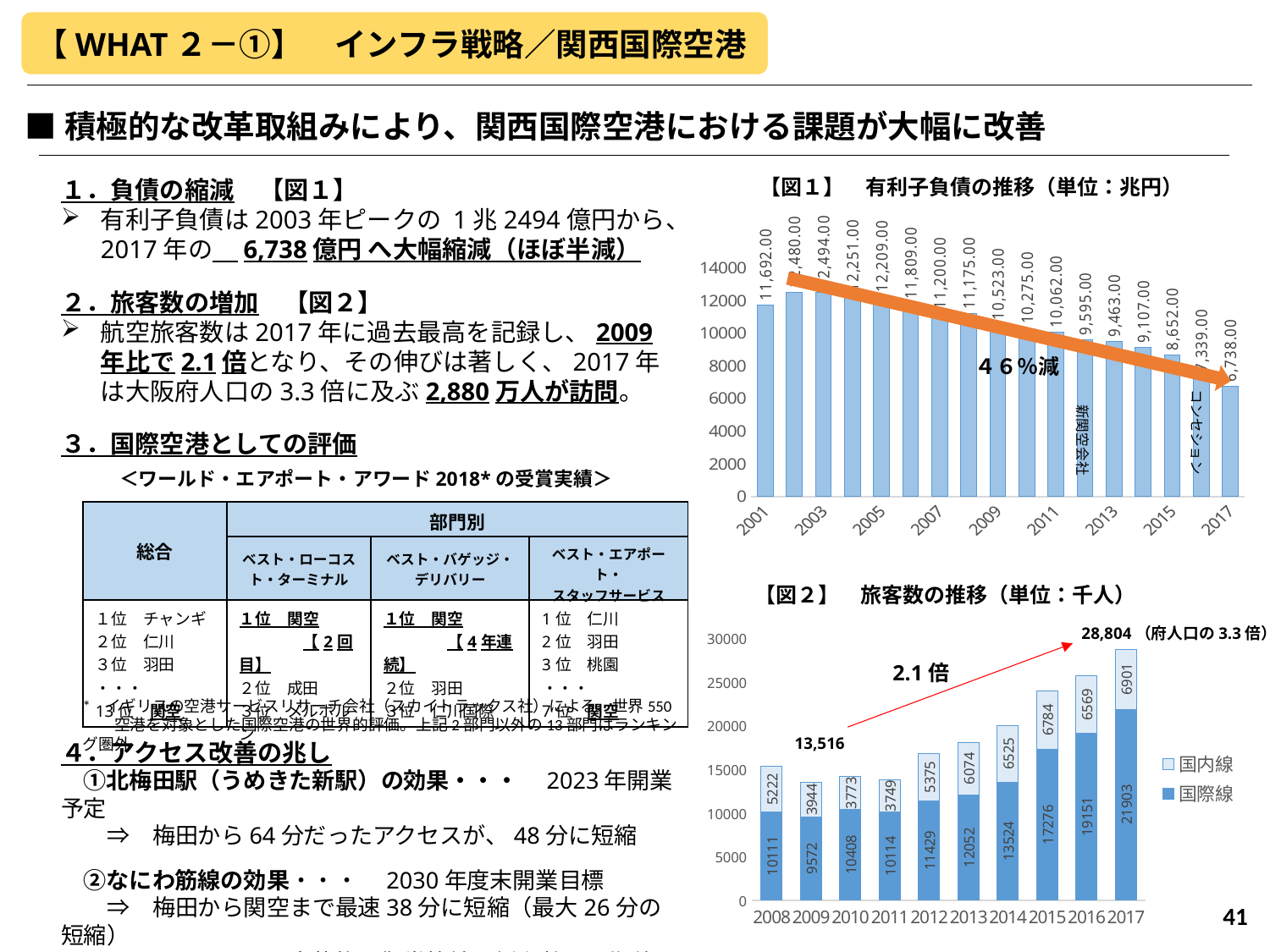
In 【図1】 有利子負債の推移, what is the value for 2009? 10,523.00 What kind of chart is 【図1】 有利子負債の推移? bar chart In 【図1】 有利子負債の推移, how many years (bars) are plotted? 17 In 【図1】 有利子負債の推移, do the values generally rise or fall from 2003 to 2017? fall How many series does the legend of 【図2】 旅客数の推移 list? 2 In 【図2】 旅客数の推移, what is the total of the stacked bar for 2015? 24060 In 【図2】 旅客数の推移, what is the 国内線 value for 2013? 6074 In 【図1】 有利子負債の推移, what is the difference between the values for 2010 and 2011? 213.00 In 【図2】 旅客数の推移, which is larger, the 国内線 value for 2008 or for 2009? 2008 In 【図2】 旅客数の推移, what is the 国際線 value for 2017? 21903 In 【図1】 有利子負債の推移, what is the value for 2001? 11,692.00 In 【図1】 有利子負債の推移, which year has the lowest value? 2017